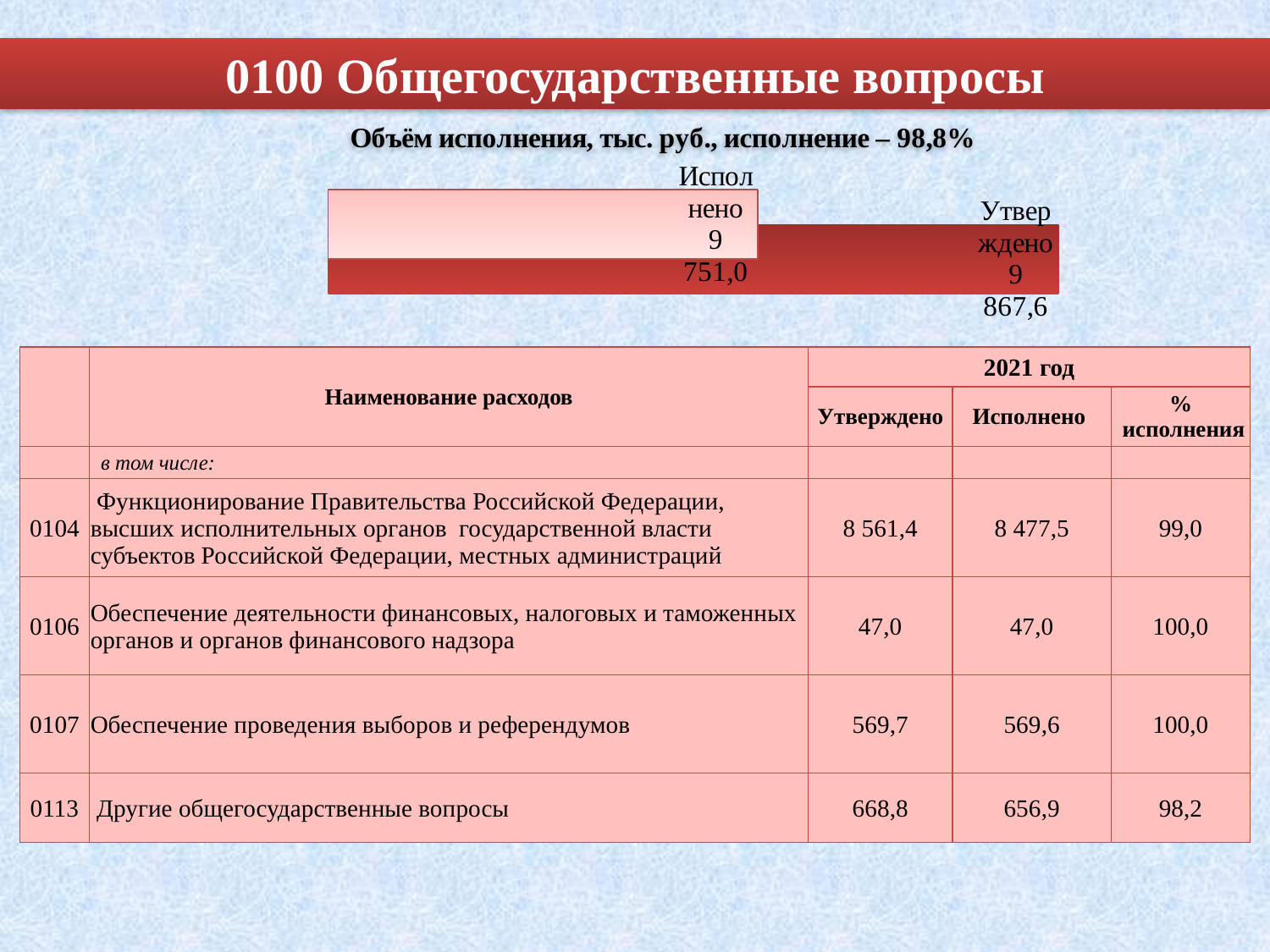
What is the difference between the Утверждено and Исполнено values in the chart? 116,6 Which bar in the chart is larger, Исполнено or Утверждено? Утверждено In what units are the chart values given, according to the chart title? тыс. руб. Which bar in the chart has the lowest value? Исполнено What execution percentage is stated in the chart title? 98,8% What is the title of the chart? Объём исполнения, тыс. руб., исполнение – 98,8% What is the value of the Утверждено bar in the chart? 9 867,6 What type of chart is shown on the slide? bar chart How many bars does the chart show? 2 What is the value of the Исполнено bar in the chart? 9 751,0